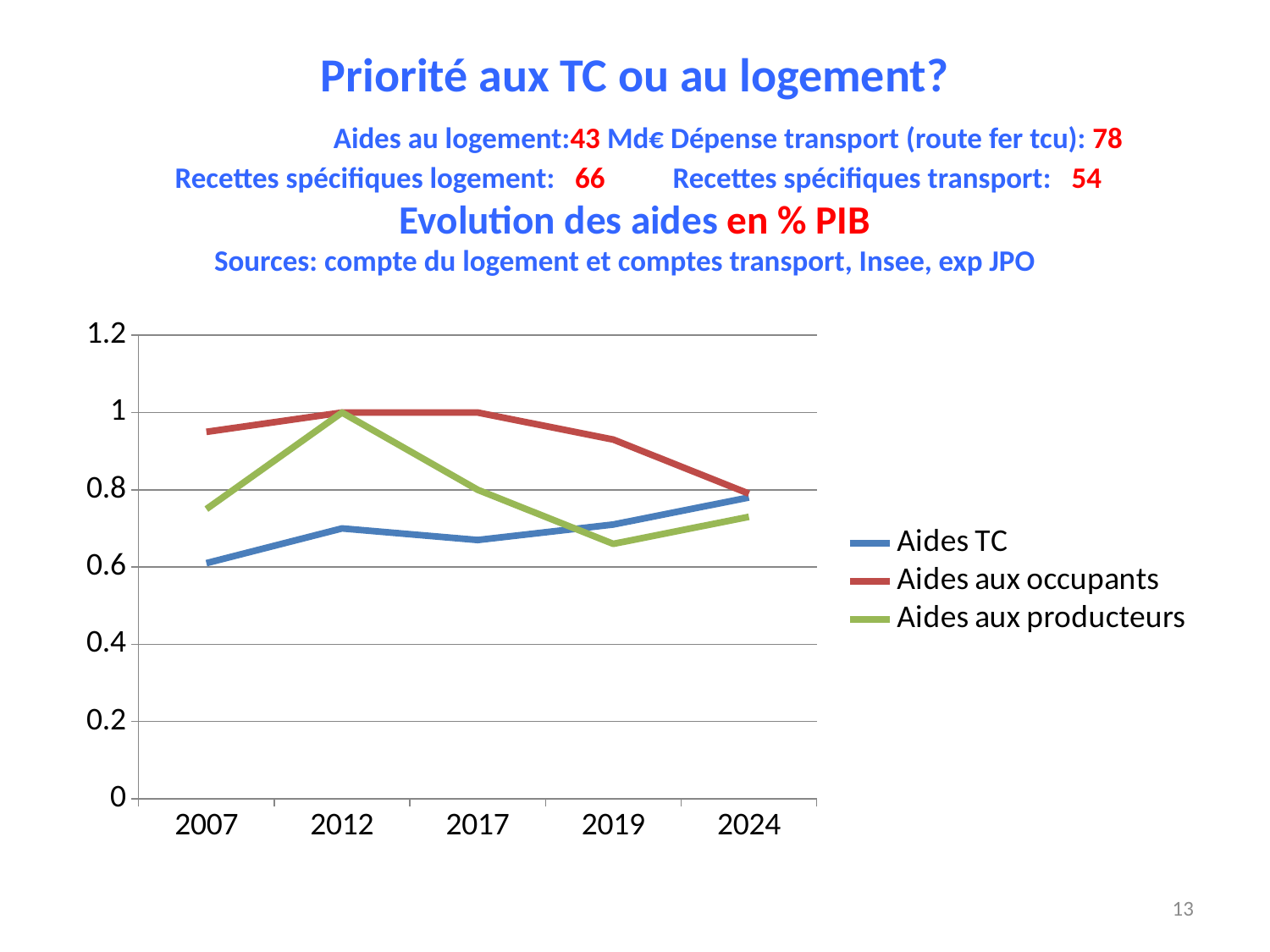
Does the Aides aux occupants line rise or fall between 2017 and 2024? fall In 2019, which is larger: Aides TC or Aides aux producteurs? Aides TC How many series does the chart legend list? 3 How many years are shown on the x axis of the chart? 5 Is the value for Aides aux occupants in 2007 greater or less than 0.8? greater Is the value for Aides TC in 2012 greater or less than 0.8? less What kind of chart is shown on the slide? line chart Which series has the highest value in 2007? Aides aux occupants Which series has the lowest value in 2019? Aides aux producteurs Which colour is used for the Aides aux producteurs line? green In 2012, which is larger: Aides aux occupants or Aides TC? Aides aux occupants Which series has the lowest value in 2007? Aides TC